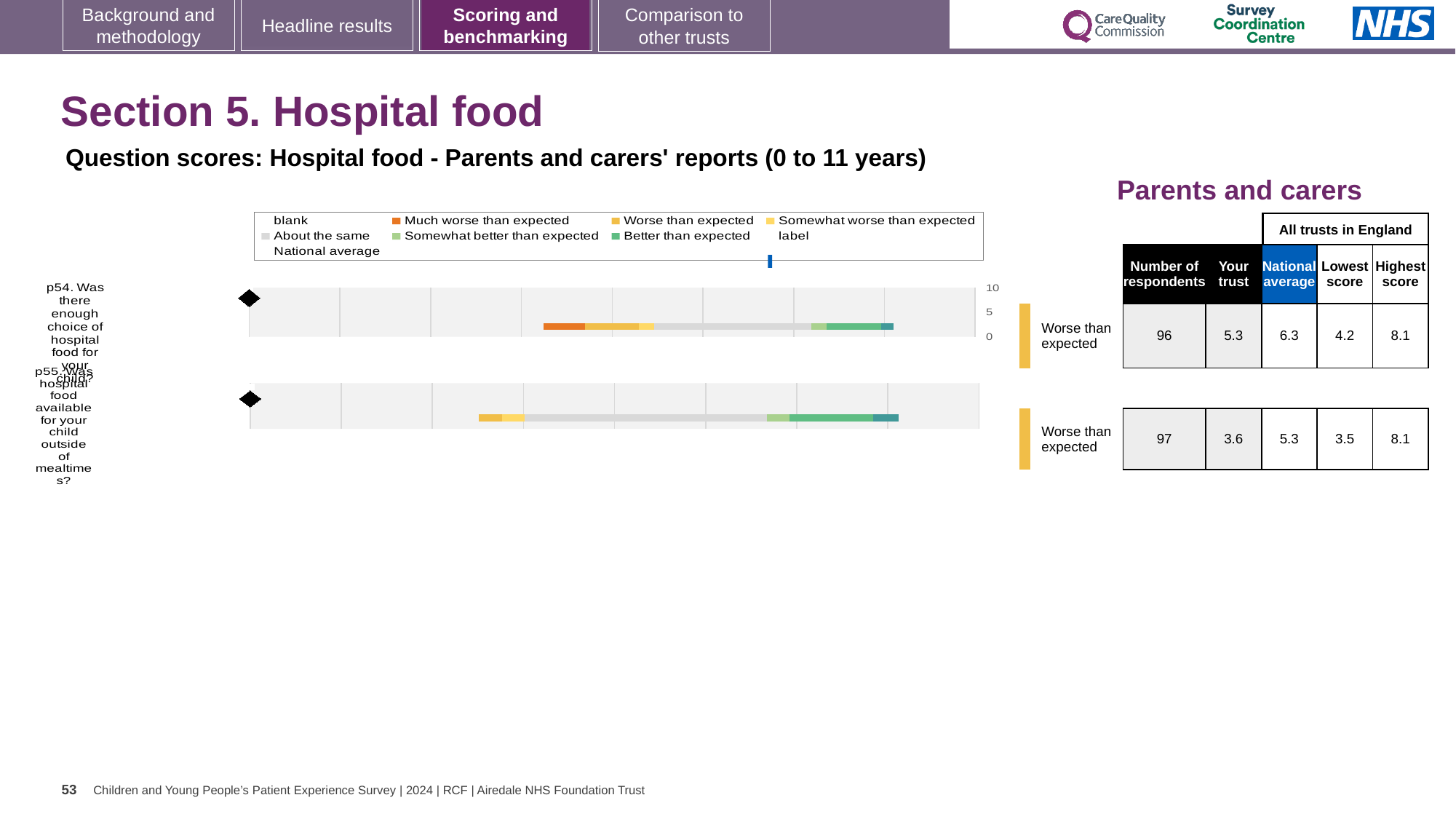
In the chart legend, what colour represents 'Better than expected'? green What is the lowest score across all trusts in England for p55? 3.5 What is the national average score for p55 (hospital food available outside of mealtimes)? 5.3 How many survey questions (p54, p55, ...) are plotted on the slide? 2 Which question has the higher 'Your trust' score, p54 or p55? p54 How many respondents answered p55? 97 What is the highest score across all trusts in England for p54? 8.1 What benchmark rating is shown next to both p54 and p55? Worse than expected What kind of chart is used to show the p54 and p55 question scores? bar chart In the chart legend, what colour represents 'Much worse than expected'? orange What is the difference between the national average and the 'Your trust' score for p55? 1.7 What is the 'Your trust' score for p54 (enough choice of hospital food)? 5.3